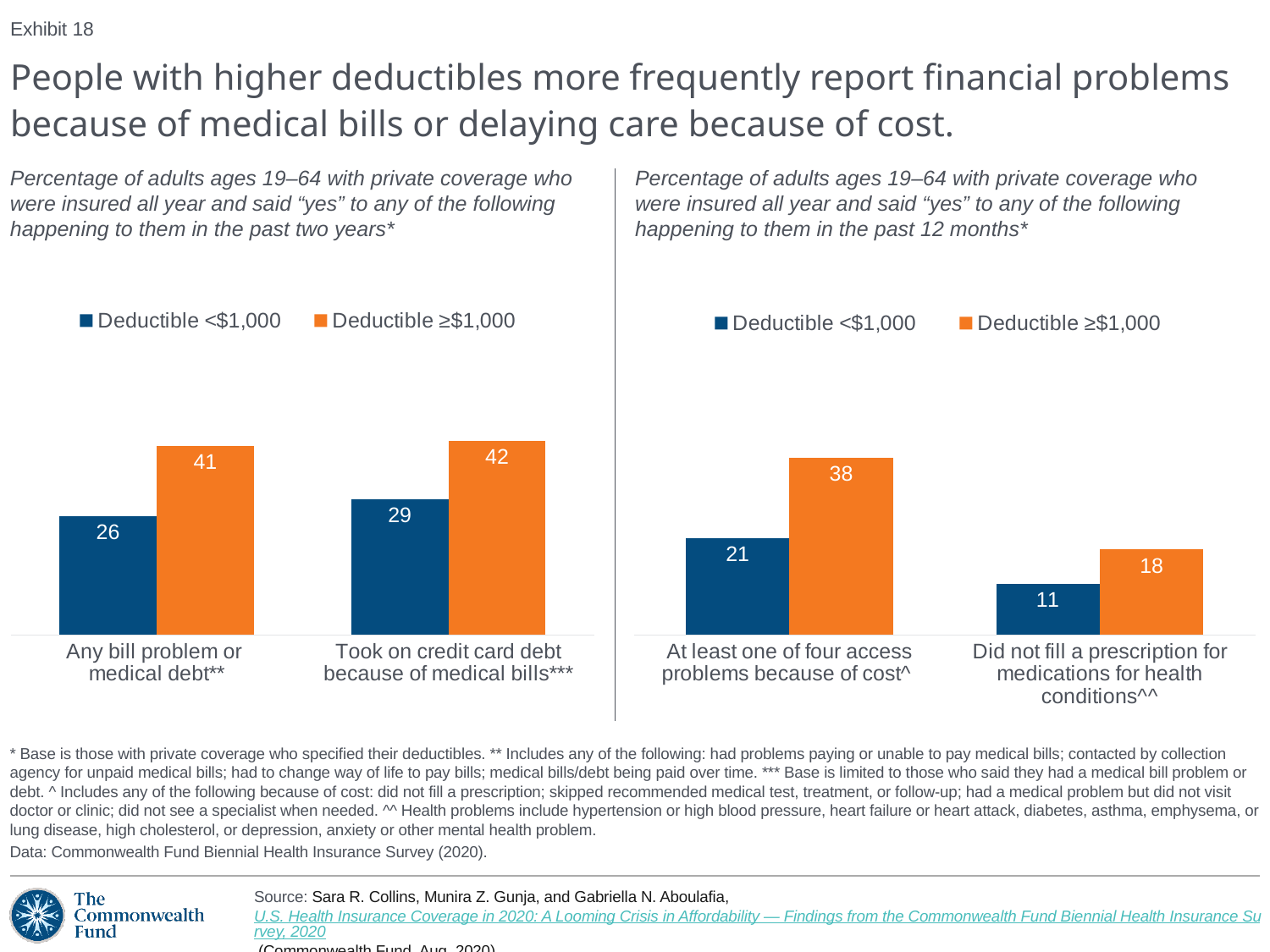
In the right chart (past 12 months), what is the value for Deductible ≥$1,000 for 'At least one of four access problems because of cost'? 38 In the left chart (past two years), what is the difference between the Deductible ≥$1,000 and Deductible <$1,000 values for 'Any bill problem or medical debt'? 15 How many series does the legend of the left chart (past two years) list? 2 In the right chart (past 12 months), which category has the lowest value for Deductible <$1,000? Did not fill a prescription for medications for health conditions How many categories are shown in the right chart (past 12 months)? 2 In the left chart (past two years), what is the value for Deductible ≥$1,000 for 'Any bill problem or medical debt'? 41 In the right chart (past 12 months), what is the value for Deductible <$1,000 for 'Did not fill a prescription for medications for health conditions'? 11 In the left chart (past two years), what is the value for Deductible <$1,000 for 'Took on credit card debt because of medical bills'? 29 What kind of chart is the left chart (past two years)? Bar chart In the right chart (past 12 months), what is the difference between the Deductible ≥$1,000 and Deductible <$1,000 values for 'At least one of four access problems because of cost'? 17 In the left chart (past two years), which category has the highest value for Deductible ≥$1,000? Took on credit card debt because of medical bills In the right chart (past 12 months), which is larger for 'Did not fill a prescription for medications for health conditions': Deductible <$1,000 or Deductible ≥$1,000? Deductible ≥$1,000